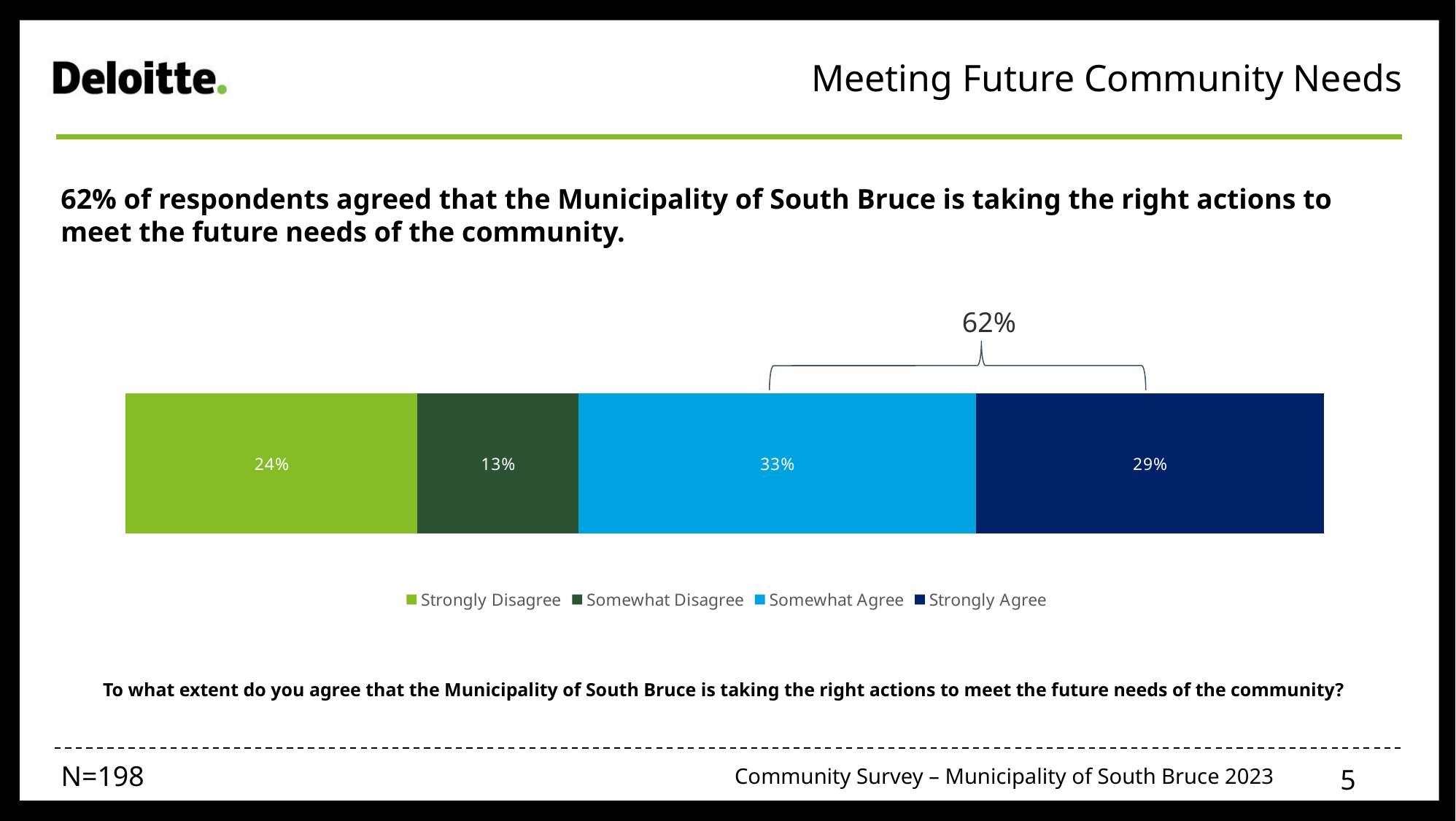
What is the combined percentage of Somewhat Agree and Strongly Agree, as labelled by the bracket above the bar? 62% Which is larger, the Strongly Disagree share or the Strongly Agree share? Strongly Agree What is the combined percentage of Strongly Disagree and Somewhat Disagree? 37% Which response category has the largest share? Somewhat Agree Which response category has the smallest share? Somewhat Disagree What percentage of respondents answered Somewhat Disagree? 13% How many series does the legend list? 4 What kind of chart is shown on the slide? Stacked bar chart What is the difference between the Somewhat Agree and Strongly Agree percentages? 4% What percentage of respondents answered Strongly Disagree? 24% What percentage of respondents answered Somewhat Agree? 33% What percentage of respondents answered Strongly Agree? 29%